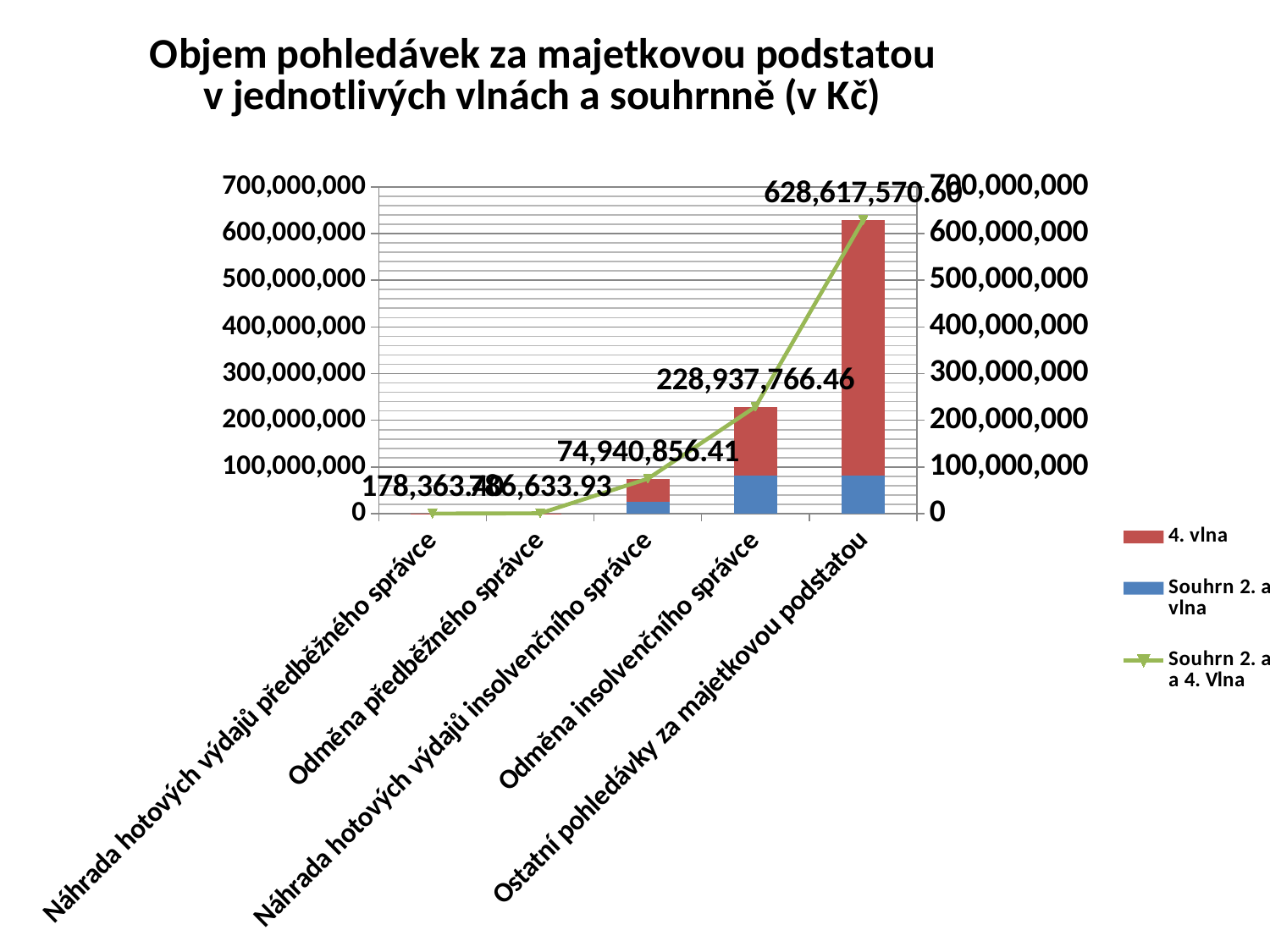
Which category has the highest value on the chart? Ostatní pohledávky za majetkovou podstatou Do the values rise or fall from left to right along the x axis? rise How many series does the legend list? 3 What is the value of the green line for Odměna insolvenčního správce? 228,937,766.46 What is the value of the green line for Náhrada hotových výdajů insolvenčního správce? 74,940,856.41 Is the value for Odměna insolvenčního správce greater or less than 300,000,000? less What colour represents the series '4. vlna' in the chart? Red What is the difference between the line values for Odměna insolvenčního správce and Náhrada hotových výdajů insolvenčního správce? 153,996,910.05 Is the value for Ostatní pohledávky za majetkovou podstatou greater or less than 600,000,000? greater How many categories are shown on the x axis of the chart? 5 What kind of chart is shown on the slide? Combined stacked bar and line chart Which is larger: the value for Odměna insolvenčního správce or the value for Náhrada hotových výdajů insolvenčního správce? Odměna insolvenčního správce